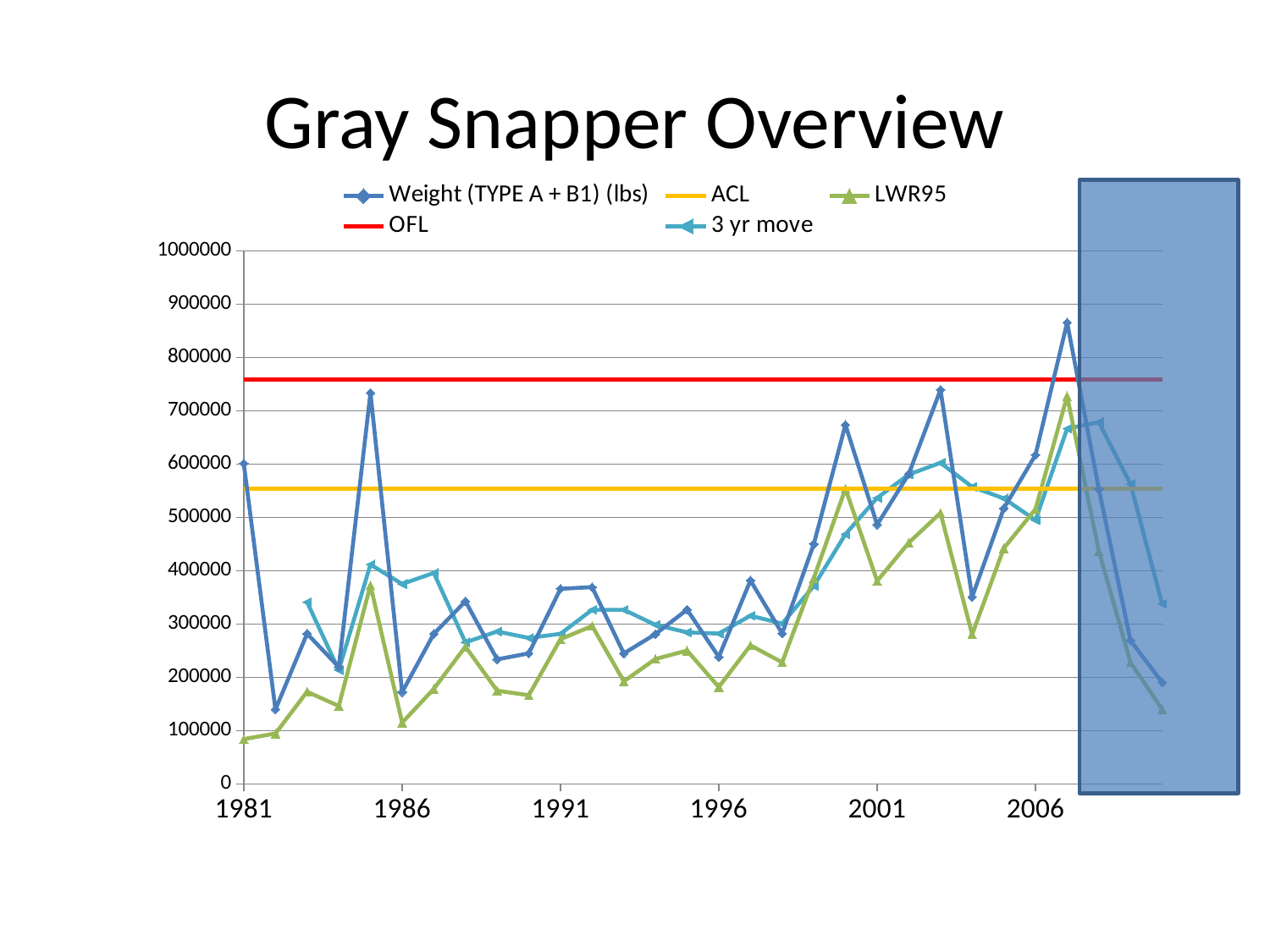
Which year has the larger Weight (TYPE A + B1) (lbs) value, 1985 or 1986? 1985 How many series does the legend list? 5 Is the Weight (TYPE A + B1) (lbs) value in 1981 greater or less than 500000? greater In which year does the Weight (TYPE A + B1) (lbs) series reach its highest value? 2007 What colour is the OFL line? red What kind of chart is shown on the slide? line chart Is the OFL line greater or less than 700000? greater Is the Weight (TYPE A + B1) (lbs) value in 1982 greater or less than 200000? less Is the Weight (TYPE A + B1) (lbs) value in 2007 above or below the OFL line? above Does the Weight (TYPE A + B1) (lbs) series rise or fall from 2007 to the last year plotted? fall